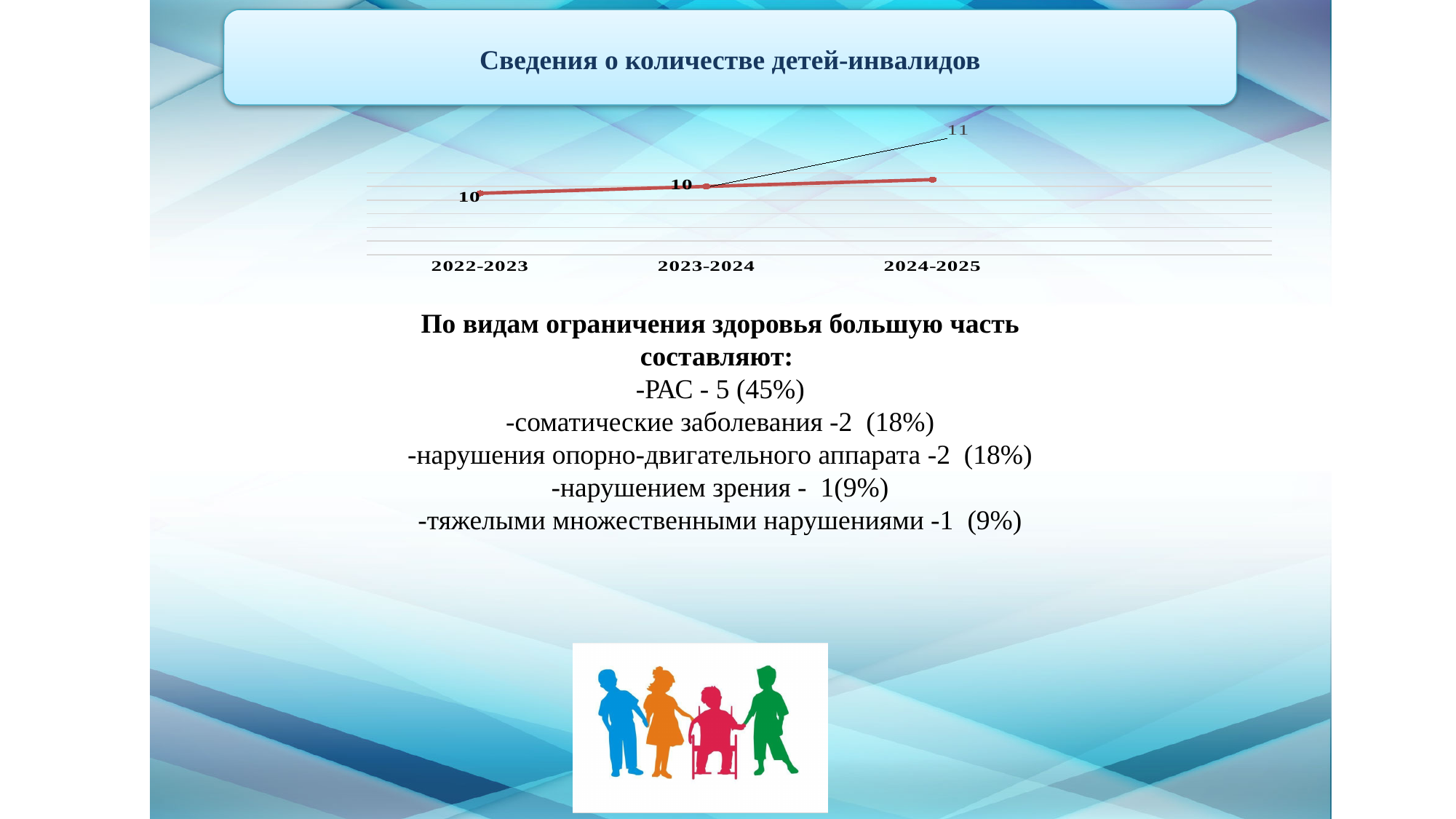
What is the value for 2023-2024? 10 How many periods are plotted on the x axis? 3 What type of chart is shown on the slide? line chart What is the title of the chart? Сведения о количестве детей-инвалидов What is the value for 2024-2025? 11 Do the values rise or fall from 2022-2023 to 2024-2025? rise What is the difference between the values for 2024-2025 and 2022-2023? 1 Which is larger, the value for 2024-2025 or the value for 2023-2024? 2024-2025 What colour is the line in the chart? red Which period has the highest value? 2024-2025 What is the value for 2022-2023? 10